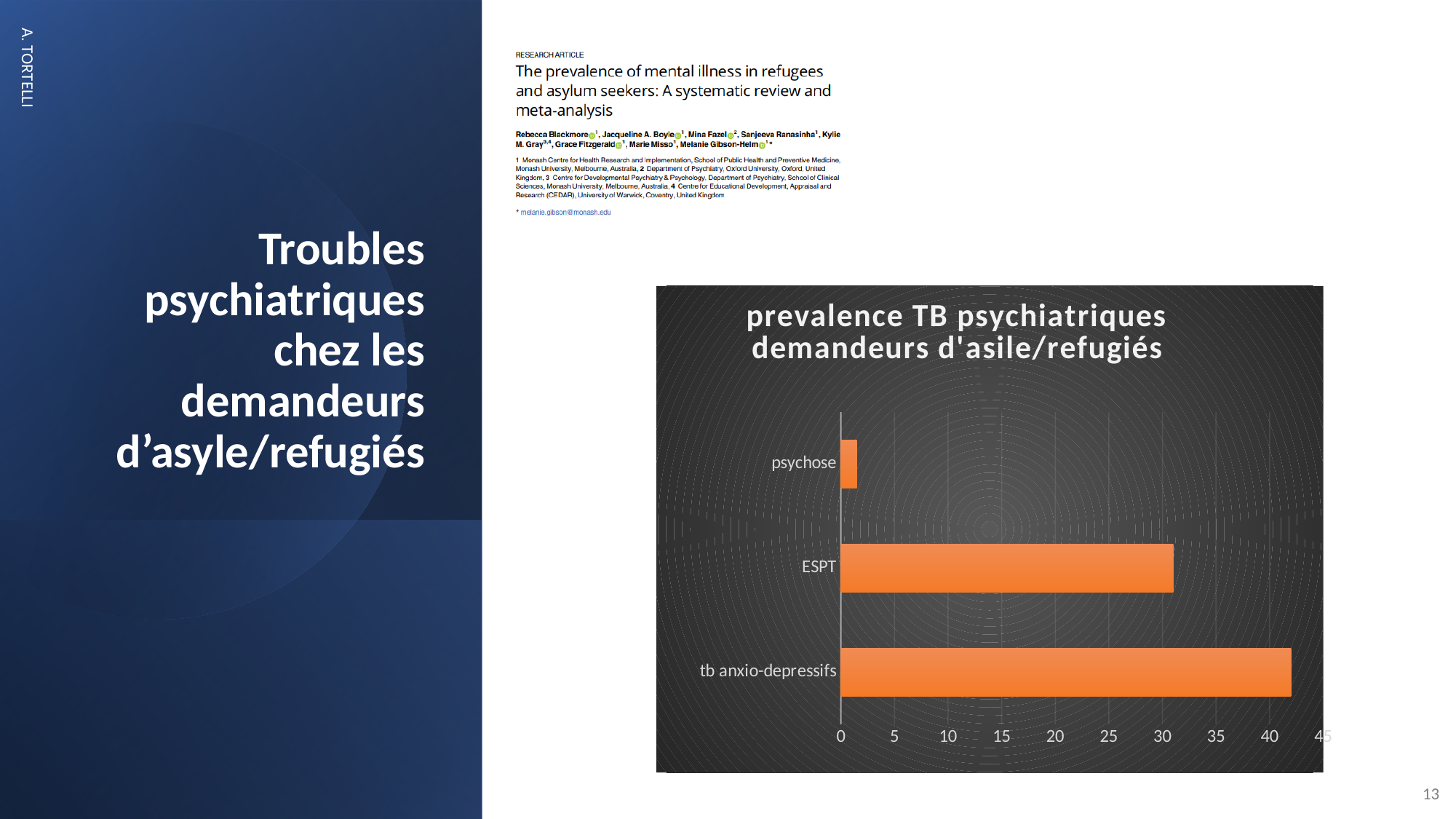
Is the value for ESPT greater or less than 35? less Which is larger, the value for ESPT or the value for psychose? ESPT Which category has the lowest value in the chart? psychose Is the value for ESPT greater or less than 25? greater Is the value for tb anxio-depressifs greater or less than 40? greater How many categories are plotted in the chart? 3 What kind of chart is shown on the slide? bar chart Which is larger, the value for tb anxio-depressifs or the value for ESPT? tb anxio-depressifs What is the highest value shown on the chart's horizontal axis? 45 What is the title of the chart? prevalence TB psychiatriques demandeurs d'asile/refugiés Which category has the highest value in the chart? tb anxio-depressifs